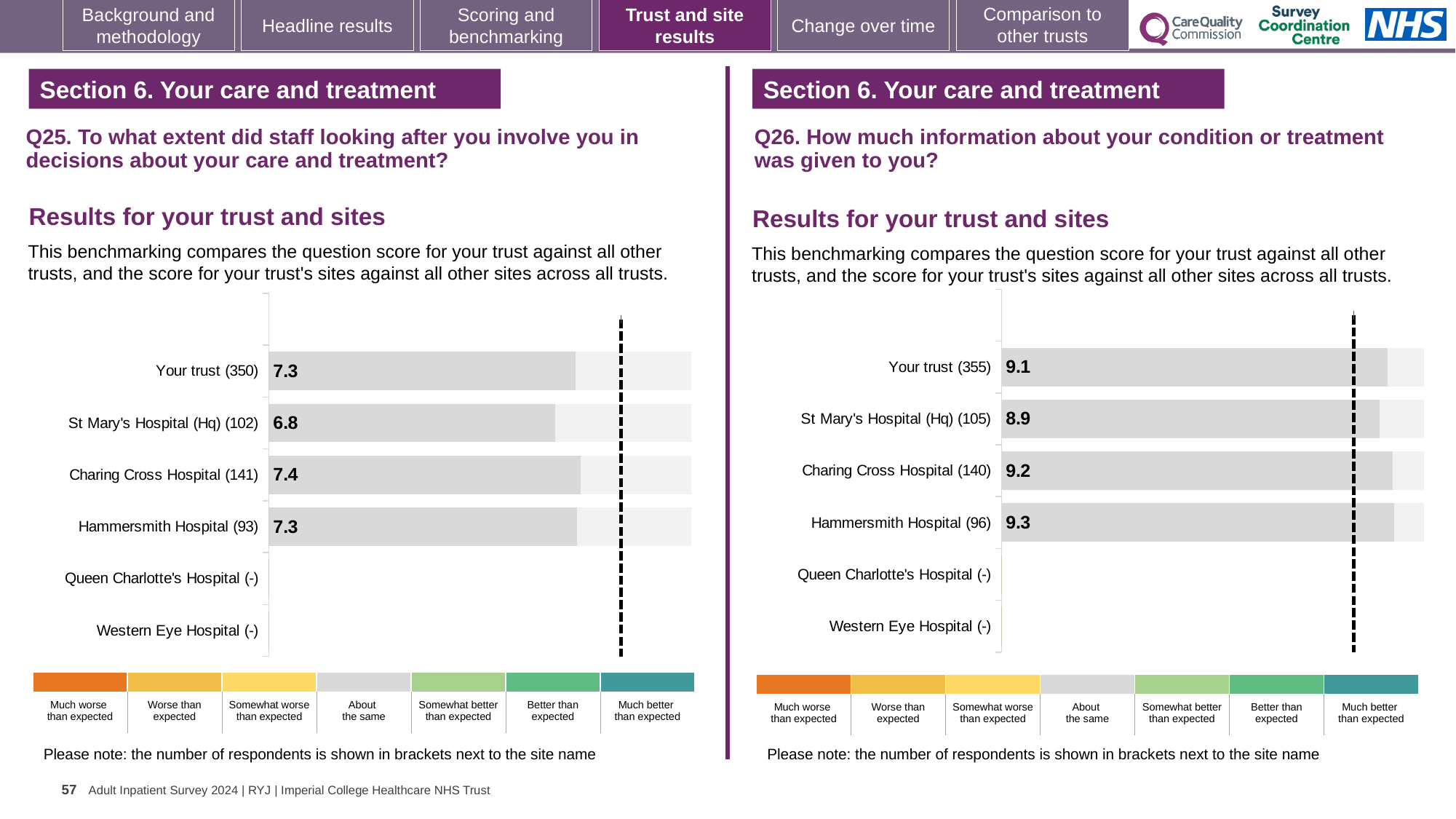
In the Q25 chart on the left, which site has the highest score? Charing Cross Hospital What kind of chart is used for the Q26 results on the right? Bar chart In the Q25 chart on the left, what is the difference between the scores for Charing Cross Hospital and St Mary's Hospital (Hq)? 0.6 In the Q25 chart on the left, which site has the lowest score? St Mary's Hospital (Hq) In the Q25 chart on the left, what is the score for Your trust? 7.3 In the Q26 chart on the right, what is the difference between the scores for Hammersmith Hospital and Your trust? 0.2 How many site rows are listed on the y axis of the Q25 chart on the left? 6 In the Q26 chart on the right, what is the score for Hammersmith Hospital? 9.3 In the Q26 chart on the right, which is larger, the score for Your trust or the score for St Mary's Hospital (Hq)? Your trust In the Q26 chart on the right, which site has the lowest score? St Mary's Hospital (Hq) In the Q26 chart on the right, what is the score for Charing Cross Hospital? 9.2 In the Q25 chart on the left, what is the score for St Mary's Hospital (Hq)? 6.8